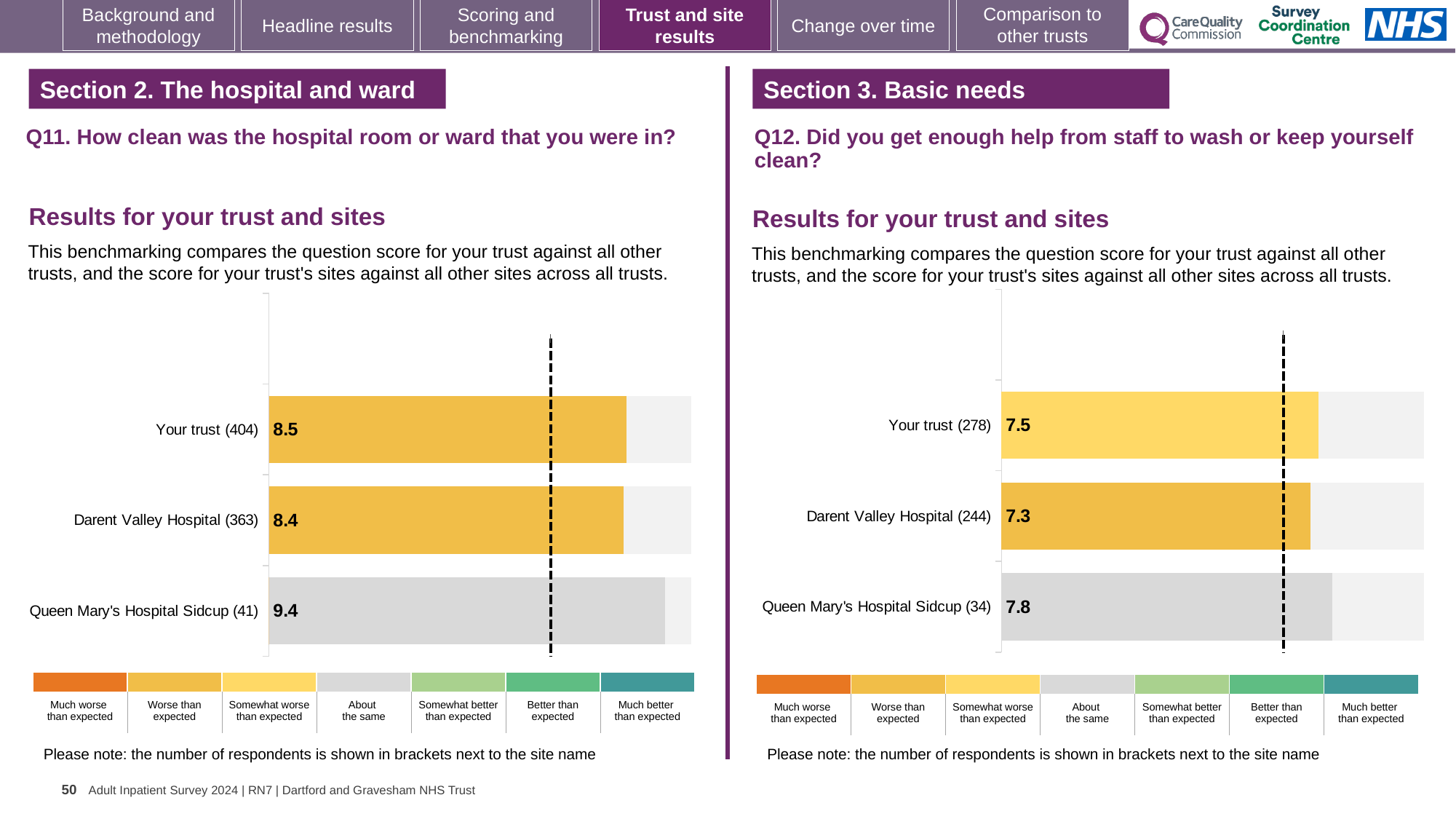
On the Q11 chart (left), which site or trust has the highest score? Queen Mary's Hospital Sidcup On the Q12 chart (right), which has the larger score, Your trust or Darent Valley Hospital? Your trust On the Q11 chart (left), what is the score for Queen Mary's Hospital Sidcup? 9.4 On the Q11 chart (left), what is the score for Your trust? 8.5 On the Q11 chart (left), what is the difference between the scores for Queen Mary's Hospital Sidcup and Darent Valley Hospital? 1.0 On the Q12 chart (right), how many respondents are shown in brackets for Queen Mary's Hospital Sidcup? 34 On the Q12 chart (right), which site or trust has the lowest score? Darent Valley Hospital What kind of chart is the Q12 chart (right)? Bar chart On the Q12 chart (right), what is the score for Your trust? 7.5 On the Q12 chart (right), what is the difference between the scores for Queen Mary's Hospital Sidcup and Your trust? 0.3 On the Q12 chart (right), what is the score for Darent Valley Hospital? 7.3 How many bars are plotted on the Q11 chart (left)? 3